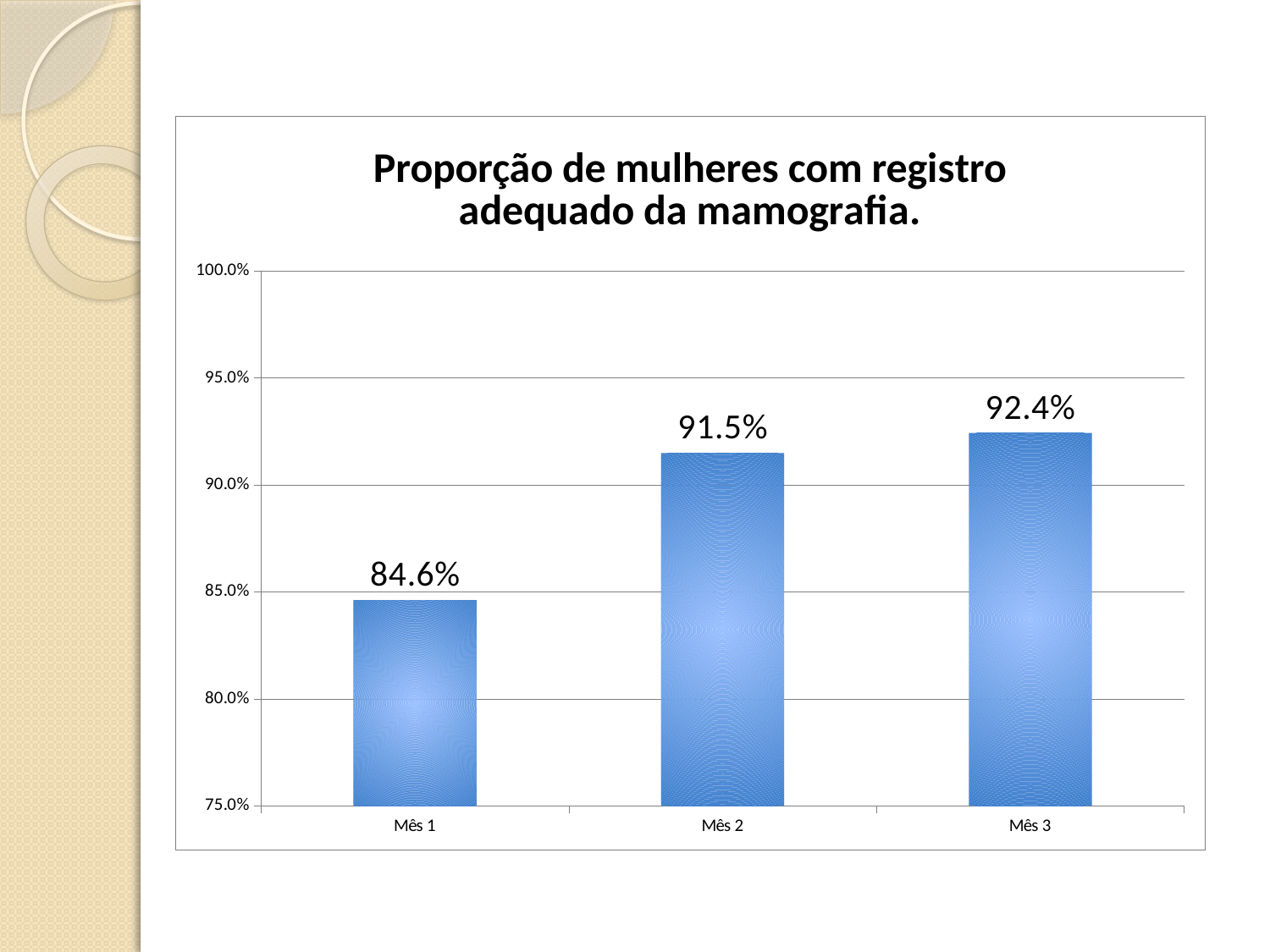
Do the values rise or fall from Mês 1 to Mês 3? rise What is the difference between the values for Mês 3 and Mês 2? 0.9% What is the difference between the values for Mês 2 and Mês 1? 6.9% Is the value for Mês 1 greater or less than 85.0%? less What kind of chart is shown on the slide? bar chart Which is larger, the value for Mês 1 or the value for Mês 2? Mês 2 What is the value for Mês 2? 91.5% Which month has the highest value? Mês 3 What is the value for Mês 1? 84.6% Which month has the lowest value? Mês 1 What is the value for Mês 3? 92.4% How many months are shown on the x axis? 3